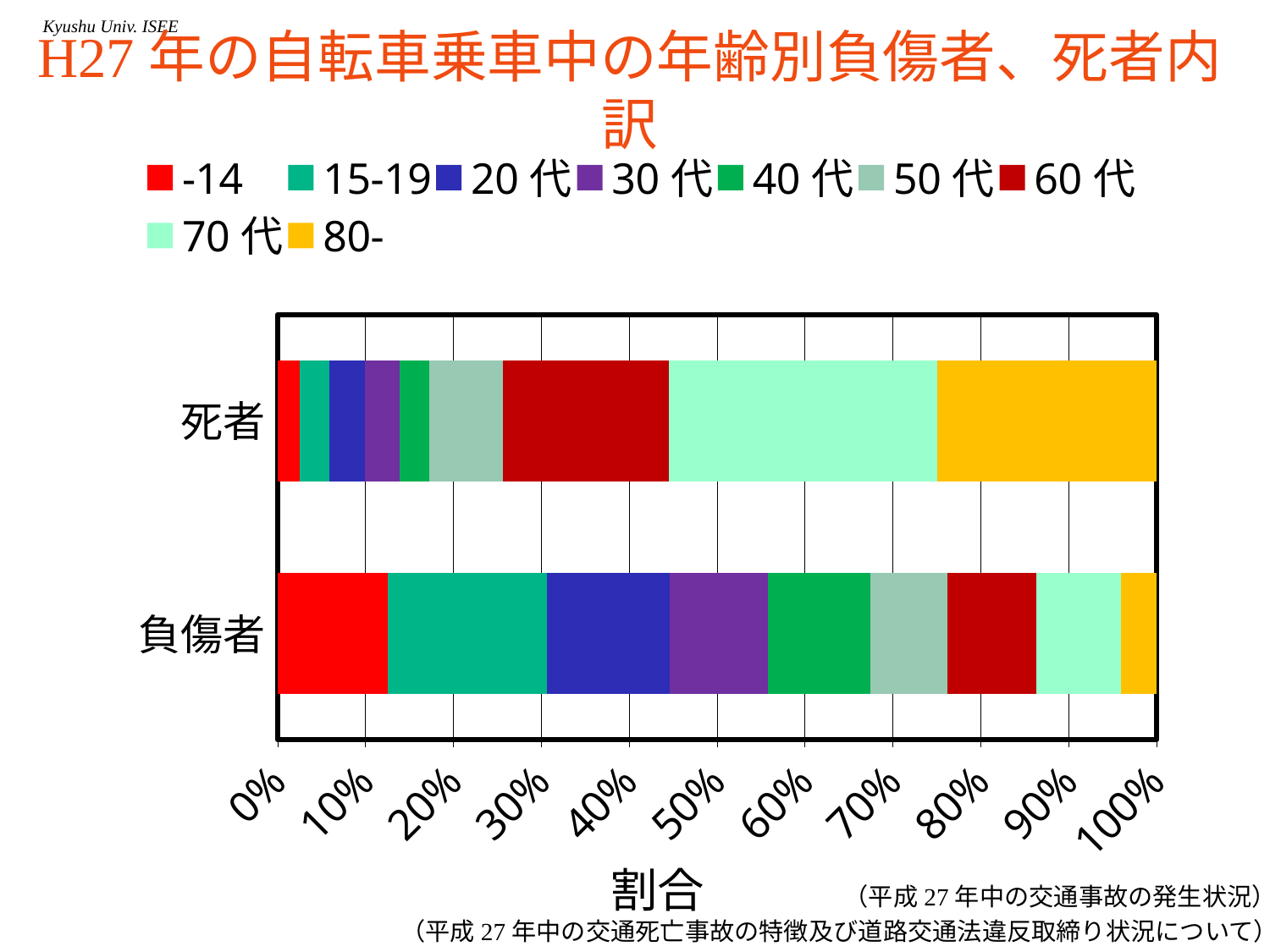
What kind of chart is shown on the slide? stacked bar chart Is the share of 80- in the 負傷者 bar greater or less than 10%? less Which age group has the smallest share in the 負傷者 bar? 80- Is the share of 70代 in the 死者 bar greater or less than 20%? greater Is the share of -14 in the 負傷者 bar greater or less than 10%? greater How many bars (categories) does the chart show? 2 How many series does the legend list? 9 Which bar has the larger share for the 80- age group, 死者 or 負傷者? 死者 Which bar has the larger share for the -14 age group, 死者 or 負傷者? 負傷者 Which age group has the largest share in the 死者 bar? 70代 Which age group has the largest share in the 負傷者 bar? 15-19 What is the label of the x axis? 割合